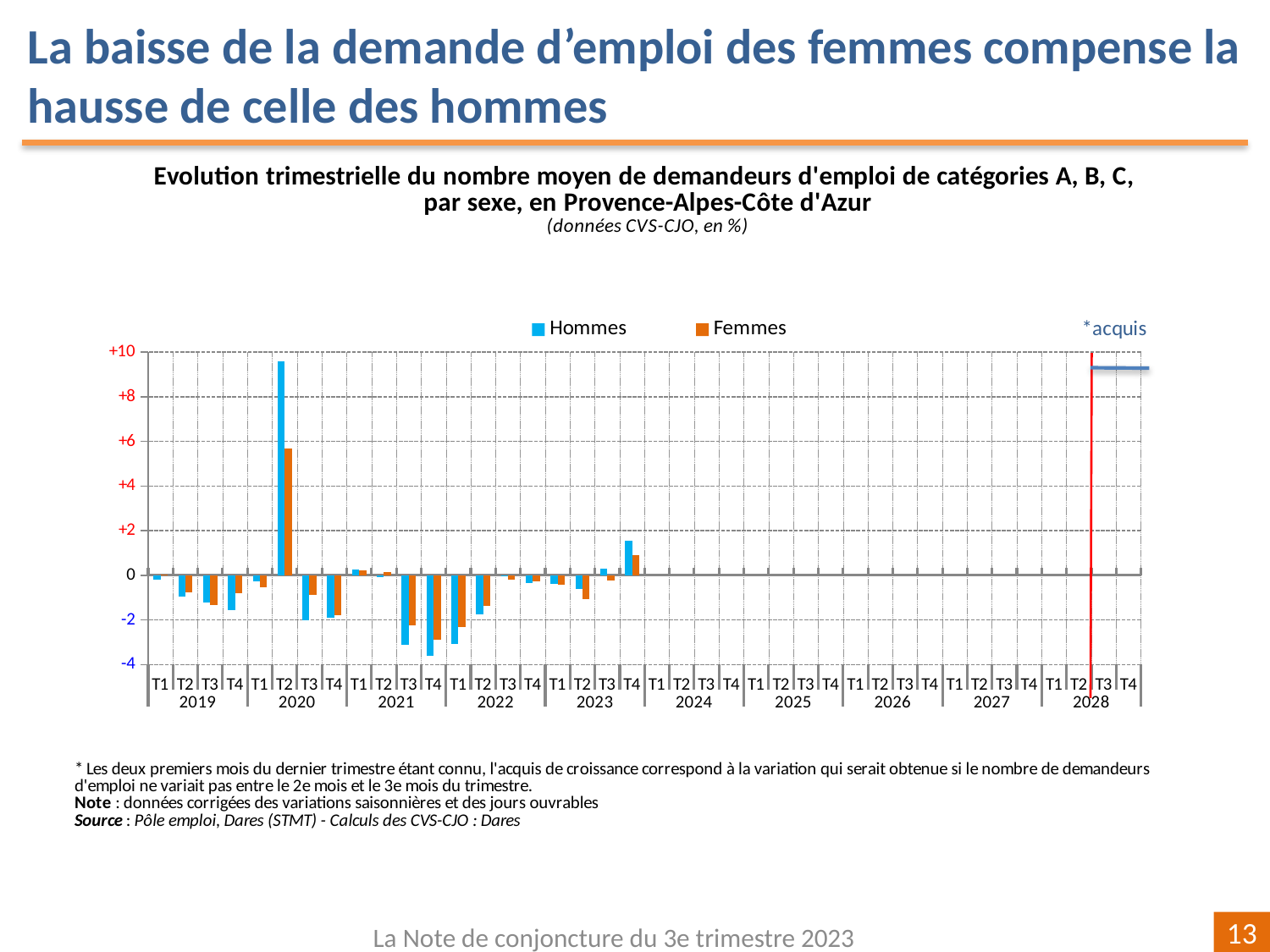
In T2 2020, which series has the larger value, Hommes or Femmes? Hommes In which quarter does the Hommes series reach its highest value? T2 2020 How many years are labelled along the x axis? 10 Is the Femmes value for T2 2020 greater or less than +4? greater What kind of chart is shown on the slide? bar chart What are the two series named in the legend? Hommes and Femmes Which region does the chart title say the data refers to? Provence-Alpes-Côte d'Azur Is the Femmes value for T4 2021 greater or less than -2? less Is the Hommes value for T2 2020 greater or less than +8? greater How many series does the legend list? 2 In T4 2023, which series has the larger value, Hommes or Femmes? Hommes